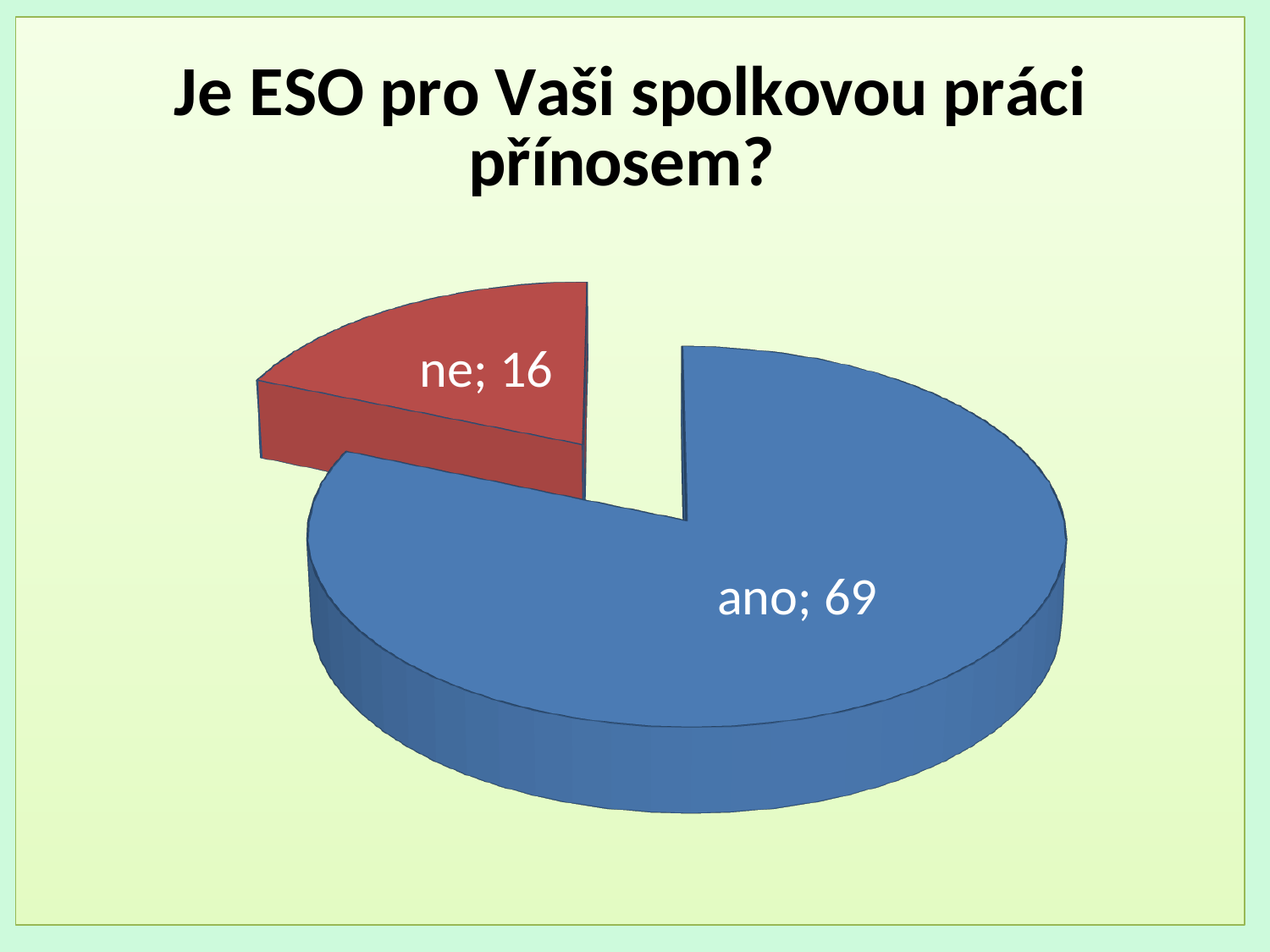
What is the value for "ano" in the pie chart? 69 What is the title of the chart on the slide? Je ESO pro Vaši spolkovou práci přínosem? What is the difference between the values for "ano" and "ne"? 53 Which slice of the pie chart is the smallest? ne What is the total of all slices in the pie chart? 85 Which is larger, the value for "ano" or the value for "ne"? ano Which slice of the pie chart is the largest? ano What is the value for "ne" in the pie chart? 16 How many slices does the pie chart have? 2 What colour is the "ne" slice of the pie chart? red What kind of chart is shown on the slide? pie chart